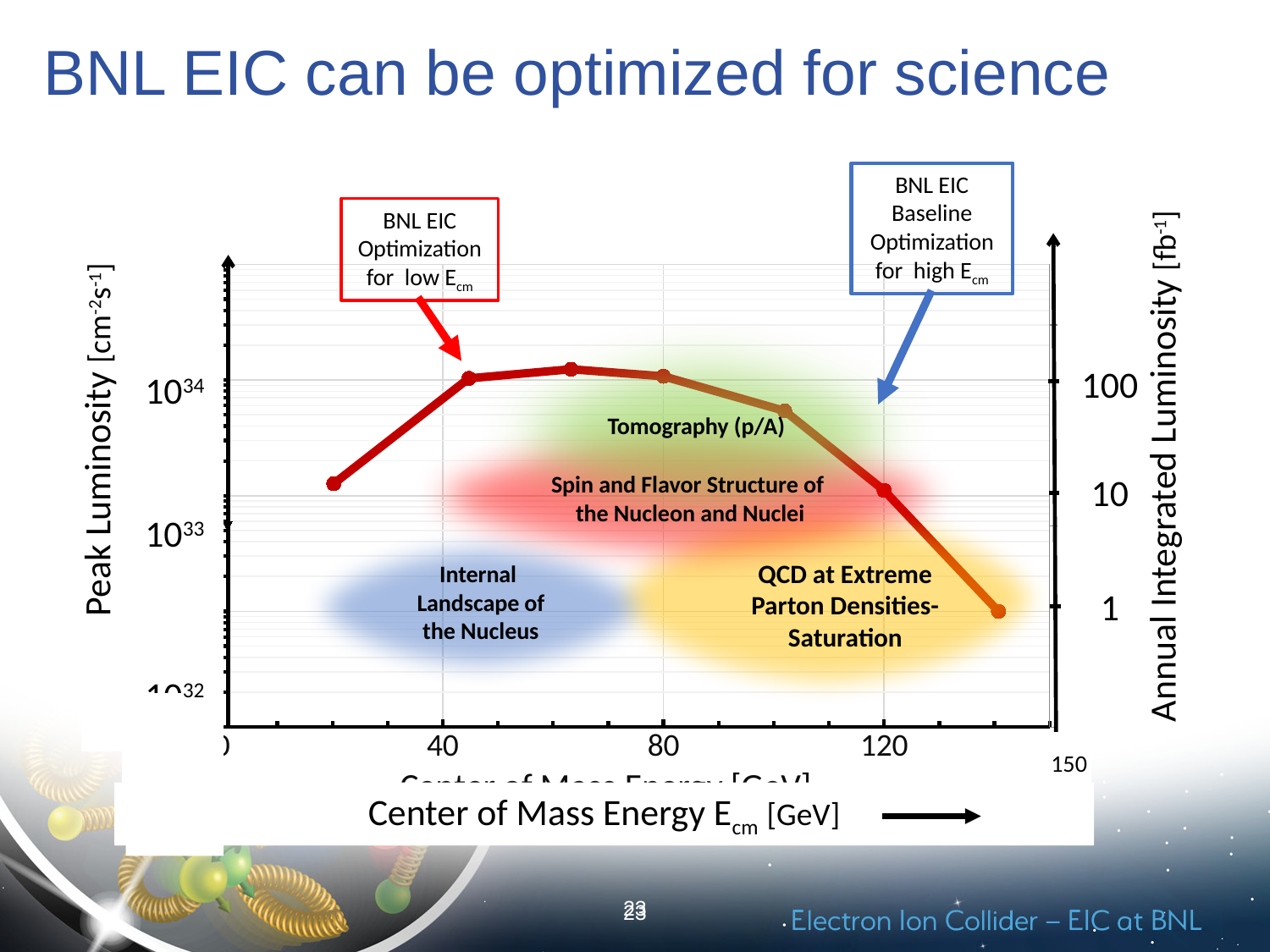
Is the peak luminosity at a center of mass energy of 80 GeV greater or less than 10^33 cm-2s-1? greater Is the peak luminosity at the highest plotted center of mass energy (around 140 GeV) greater or less than 10^33 cm-2s-1? less At which plotted center of mass energy is the peak luminosity lowest? the highest energy point, around 140 GeV How does the peak luminosity change as the center of mass energy increases from 20 GeV to about 45 GeV? it rises What kind of chart is shown on the slide? line chart Is the peak luminosity at a center of mass energy of 120 GeV greater or less than 10^34 cm-2s-1? less What is the label of the right vertical axis? Annual Integrated Luminosity [fb-1] How many data points are plotted on the line? 7 Which is larger: the peak luminosity at about 45 GeV or at 120 GeV? about 45 GeV What is the label of the left vertical axis? Peak Luminosity [cm-2s-1] How does the peak luminosity change as the center of mass energy increases from 80 GeV to 140 GeV? it falls